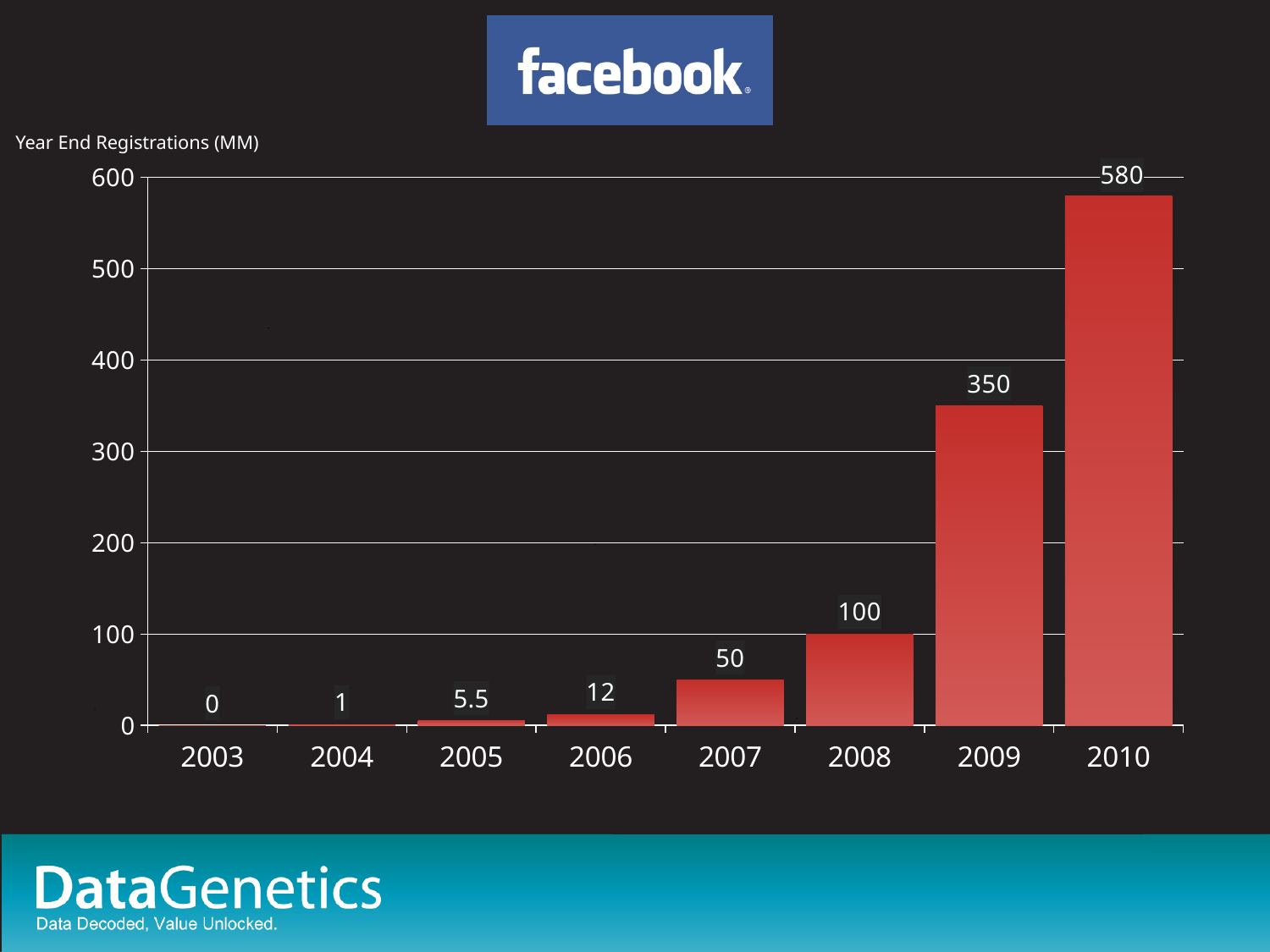
What is the value for 2010? 580 What is the value for 2008? 100 How many years are shown on the x axis? 8 Which year has the highest value? 2010 What is the difference between the values for 2007 and 2006? 38 Is the value for 2009 greater or less than 300? greater What kind of chart is shown? bar chart What is the value for 2005? 5.5 Which is larger, the value for 2008 or the value for 2009? 2009 Which year has the lowest value? 2003 What is the difference between the values for 2010 and 2009? 230 Do the values rise or fall from 2003 to 2010? rise